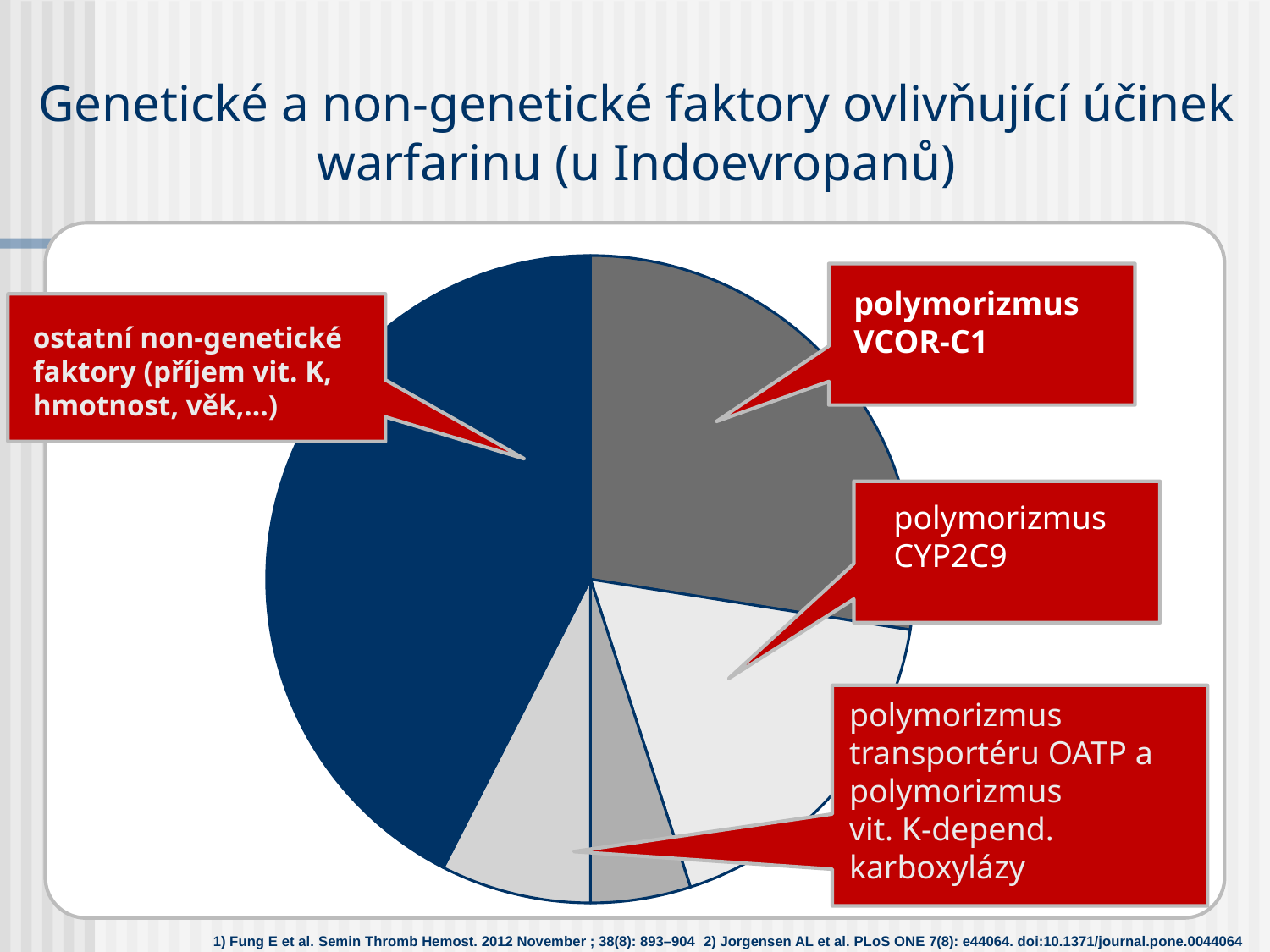
What colour is the slice labelled ostatní non-genetické faktory? dark blue Which is larger in the pie chart: the slice for ostatní non-genetické faktory or the slice for polymorizmus VCOR-C1? ostatní non-genetické faktory How many slices does the pie chart have? 5 Which slice is larger: polymorizmus CYP2C9 or polymorizmus transportéru OATP? polymorizmus CYP2C9 Which slice of the pie chart is the largest? ostatní non-genetické faktory (příjem vit. K, hmotnost, věk,...) Which is larger in the pie chart: the slice for polymorizmus VCOR-C1 or the slice for polymorizmus CYP2C9? polymorizmus VCOR-C1 What colour is the slice labelled polymorizmus VCOR-C1? dark gray What kind of chart is shown on the slide? pie chart